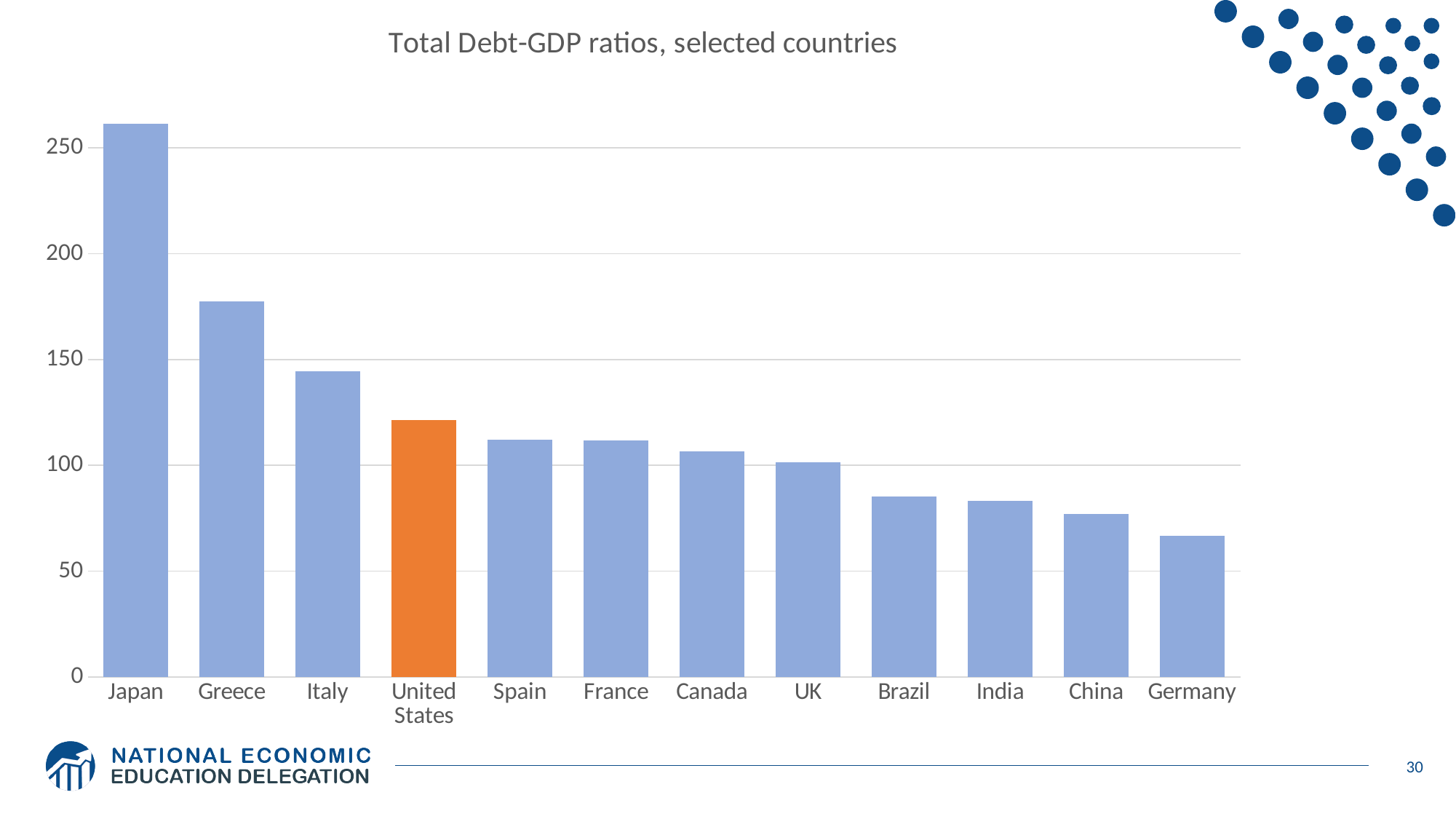
Which has a higher total debt-GDP ratio, Italy or Spain? Italy How many countries are shown on the chart? 12 What kind of chart is shown on the slide? bar chart Which country has the highest total debt-GDP ratio? Japan Is the value for Germany greater or less than 50? greater Do the values rise or fall moving from left to right along the x axis? fall Which country has the lowest total debt-GDP ratio? Germany Which country's bar is coloured orange? United States Is the value for Greece greater or less than 200? less Is the value for the United States greater or less than 100? greater What is the title of the chart? Total Debt-GDP ratios, selected countries